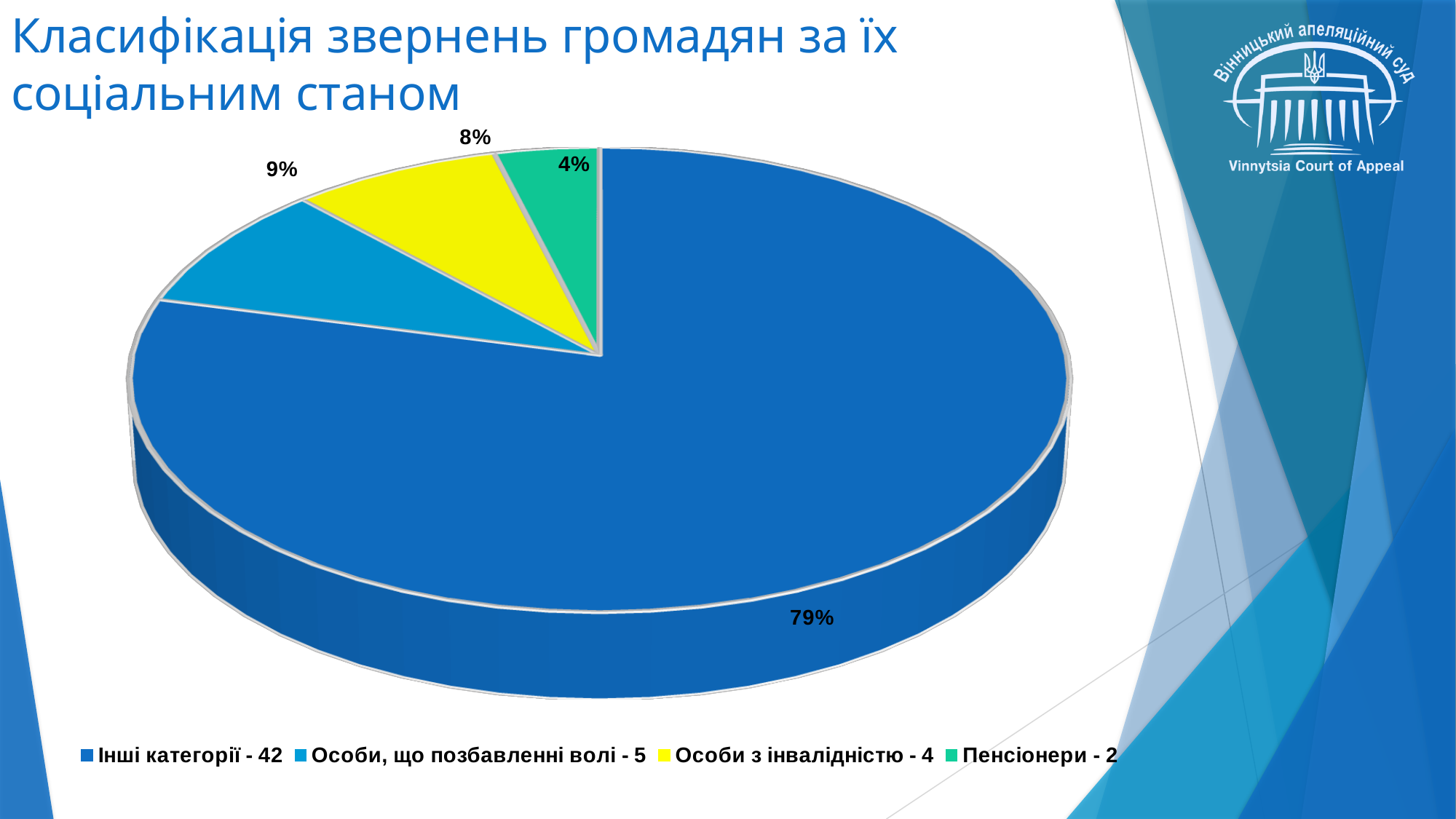
What is the title of the slide containing the chart? Класифікація звернень громадян за їх соціальним станом What percentage share does the slice "Особи з інвалідністю" have? 8% Which category has the largest slice of the pie? Інші категорії What percentage share does the slice "Інші категорії" have? 79% What percentage share does the slice "Особи, що позбавленні волі" have? 9% What kind of chart is shown on the slide? Pie chart What is the difference in percentage points between the "Особи, що позбавленні волі" slice and the "Пенсіонери" slice? 5% Which category has the smallest slice of the pie? Пенсіонери According to the legend, how many appeals are in the category "Інші категорії"? 42 According to the legend, how many appeals are from "Пенсіонери"? 2 How many categories (slices) does the pie chart have? 4